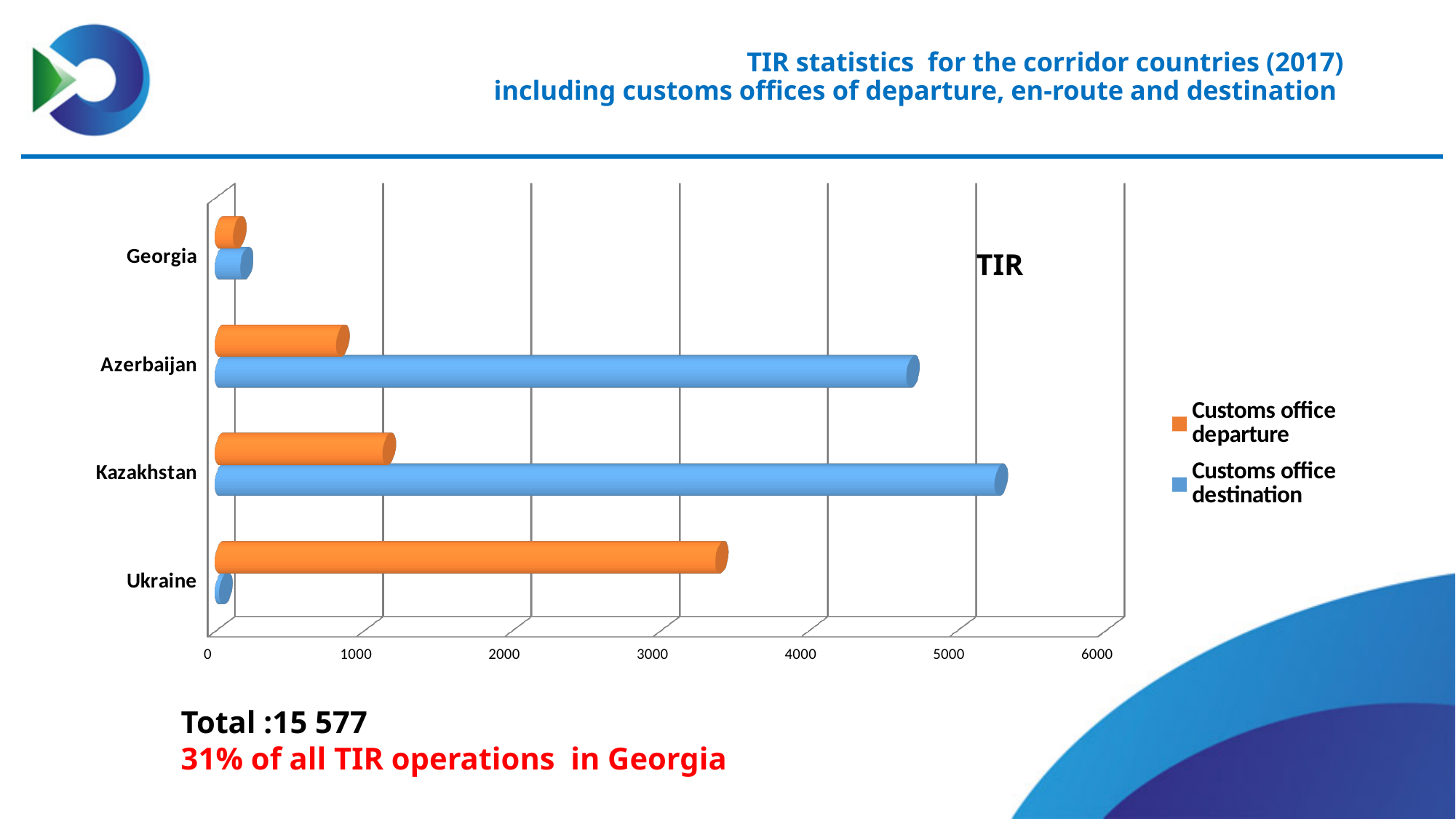
How many countries are shown on the chart? 4 Is the Customs office departure value for Azerbaijan greater or less than 1000? less Which country has the highest value for Customs office departure? Ukraine Is the Customs office destination value for Kazakhstan greater or less than 5000? greater Which country has the lowest value for Customs office destination? Ukraine Which country has the lowest value for Customs office departure? Georgia Is the Customs office departure value for Ukraine greater or less than 3000? greater What kind of chart is shown on the slide? Bar chart Which country has the highest value for Customs office destination? Kazakhstan For Azerbaijan, which is larger: Customs office departure or Customs office destination? Customs office destination Which colour represents the Customs office departure series? Orange How many series does the legend list? 2